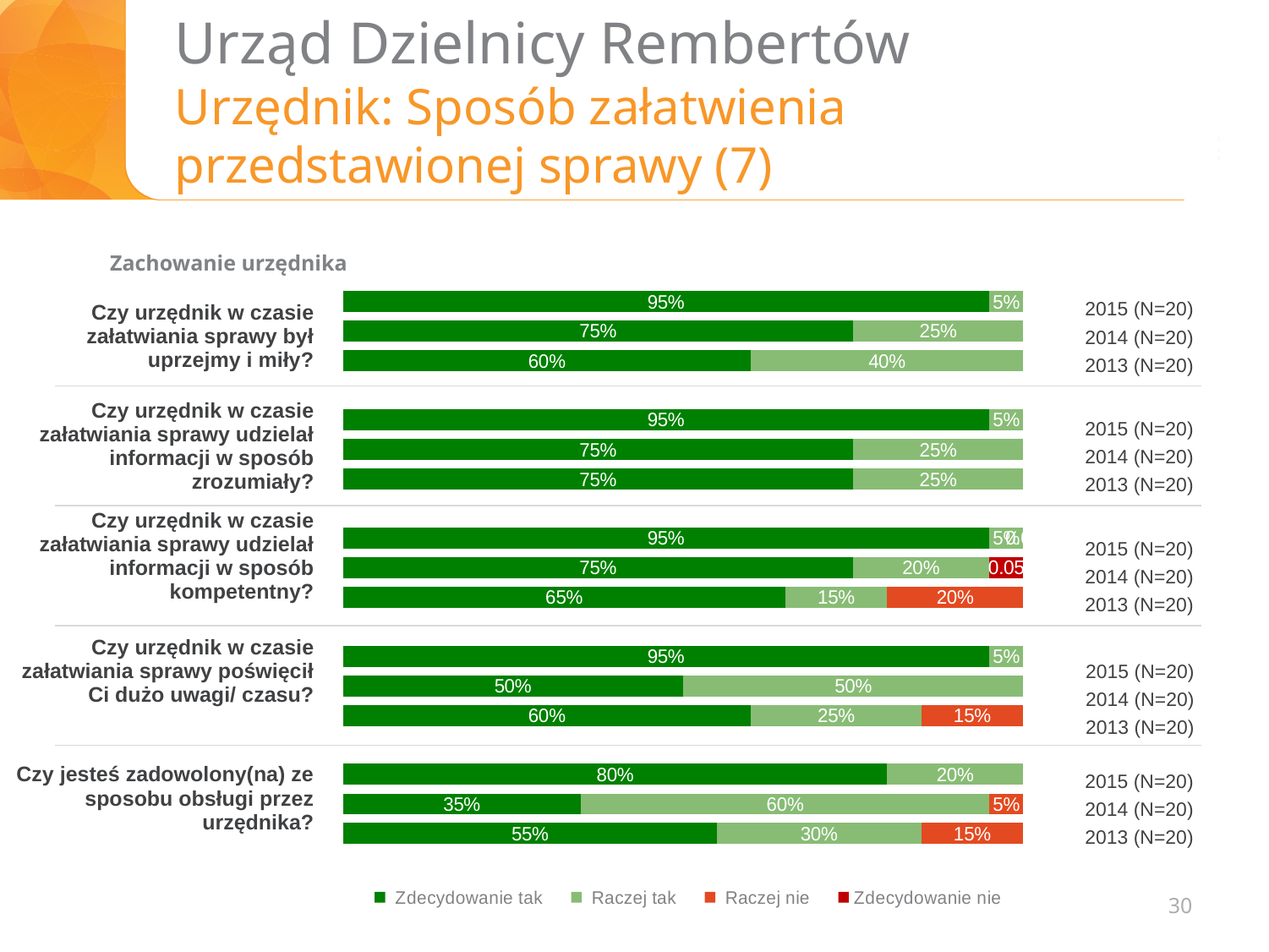
For "Czy urzędnik w czasie załatwiania sprawy był uprzejmy i miły?", is the "Zdecydowanie tak" share larger in 2014 or in 2013? 2014 What kind of chart is shown on the slide? Stacked bar chart What share of respondents in 2013 answered "Raczej nie" to "Czy urzędnik w czasie załatwiania sprawy udzielał informacji w sposób kompetentny?"? 20% For "Czy jesteś zadowolony(na) ze sposobu obsługi przez urzędnika?", which year has the highest "Zdecydowanie tak" share? 2015 What is the sample size (N) shown for each year in the chart? N=20 For "Czy urzędnik w czasie załatwiania sprawy był uprzejmy i miły?", does the "Zdecydowanie tak" share rise or fall from 2013 to 2015? Rise What share of respondents in 2013 answered "Raczej tak" to "Czy urzędnik w czasie załatwiania sprawy był uprzejmy i miły?"? 40% For "Czy urzędnik w czasie załatwiania sprawy poświęcił Ci dużo uwagi/ czasu?", what is the difference between the "Zdecydowanie tak" share in 2015 and in 2014? 45 percentage points What share of respondents in 2013 answered "Raczej nie" to "Czy urzędnik w czasie załatwiania sprawy poświęcił Ci dużo uwagi/ czasu?"? 15% What share of respondents in 2015 answered "Zdecydowanie tak" to "Czy urzędnik w czasie załatwiania sprawy był uprzejmy i miły?"? 95% What share of respondents in 2014 answered "Zdecydowanie tak" to "Czy jesteś zadowolony(na) ze sposobu obsługi przez urzędnika?"? 35% How many series does the legend list? 4